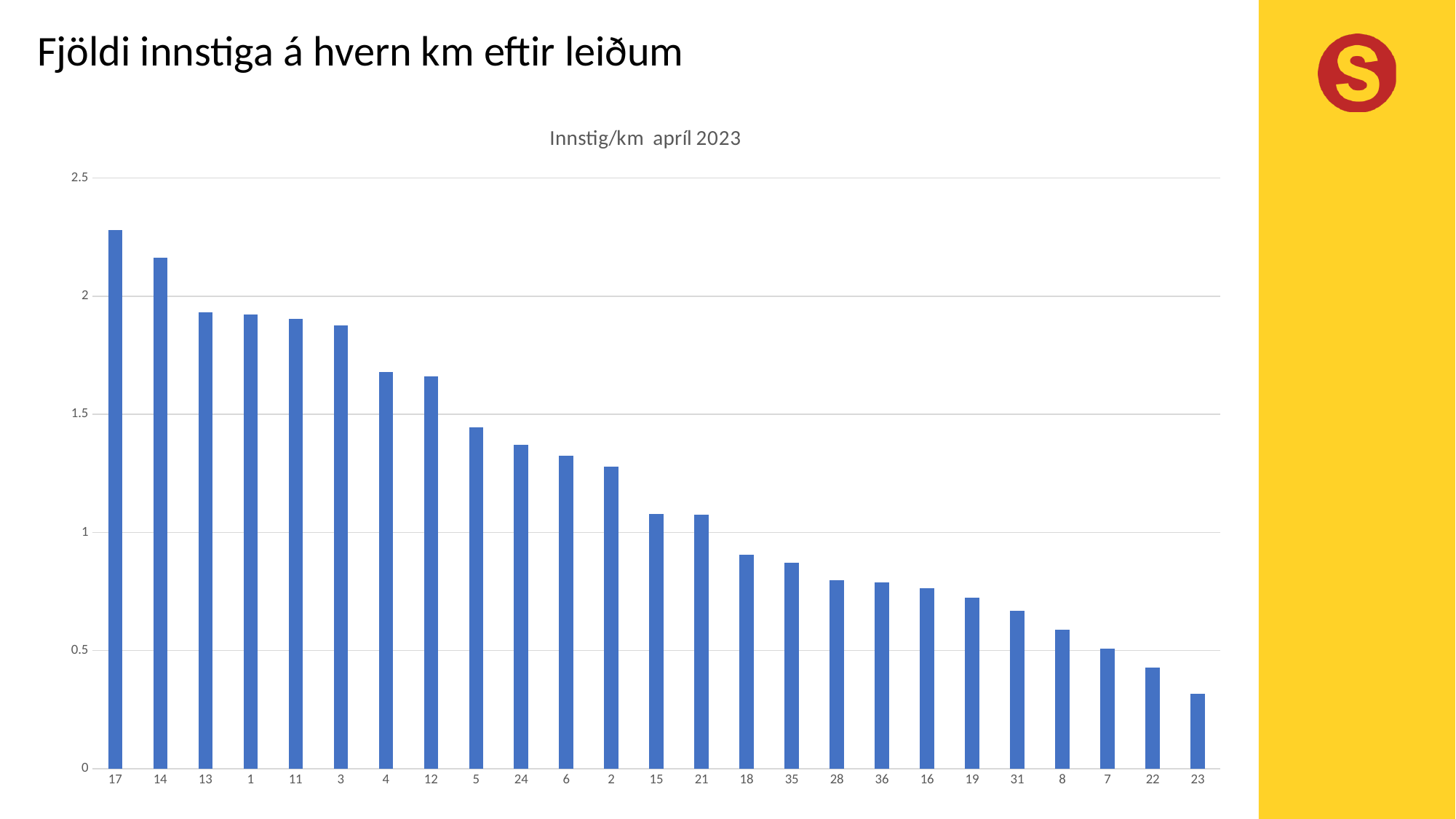
Is the value for route 18 greater or less than 1? less How many routes (categories) are shown on the x axis of the chart? 25 Is the value for route 5 greater or less than 1.5? less Is the value for route 17 greater or less than 2? greater Which has the larger value, route 14 or route 6? 14 Which route has the highest value in the chart? 17 Which route has the lowest value in the chart? 23 Do the values rise or fall from left to right along the x axis? fall What kind of chart is shown on the slide? bar chart What is the title of the chart? Innstig/km apríl 2023